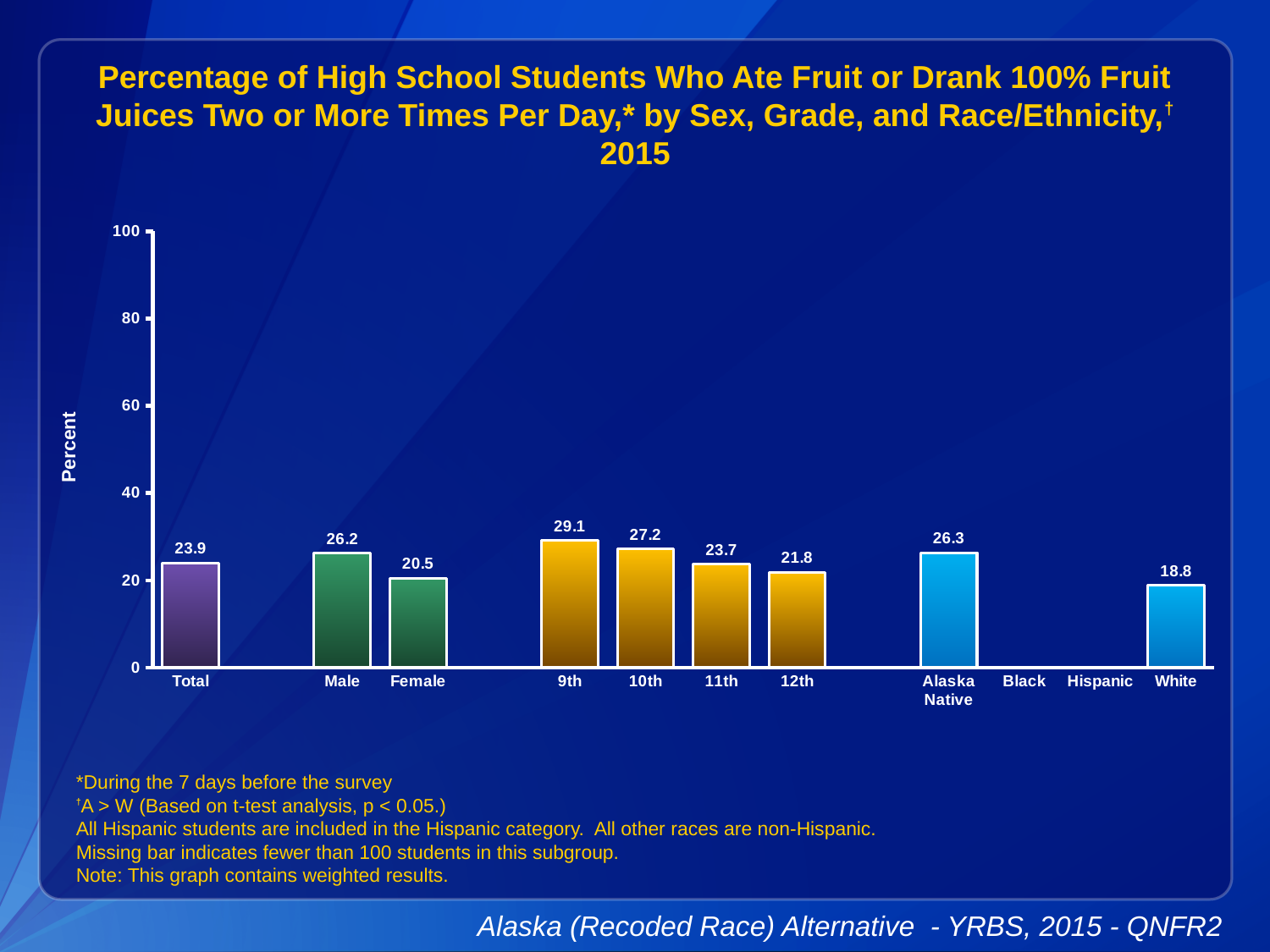
What is the value for Female? 20.5 What is the difference between the Male and Female values? 5.7 Do the values fall or rise from 9th grade to 12th grade? fall What is the value for Total? 23.9 How many categories are labeled on the x axis? 11 What kind of chart is shown? bar chart Which category with a plotted bar has the lowest value? White Which is larger, the value for 11th grade or the value for 12th grade? 11th What is the value for Alaska Native? 26.3 Is the value for 9th grade greater or less than 20? greater Which category has the highest value? 9th What is the value for 10th grade? 27.2